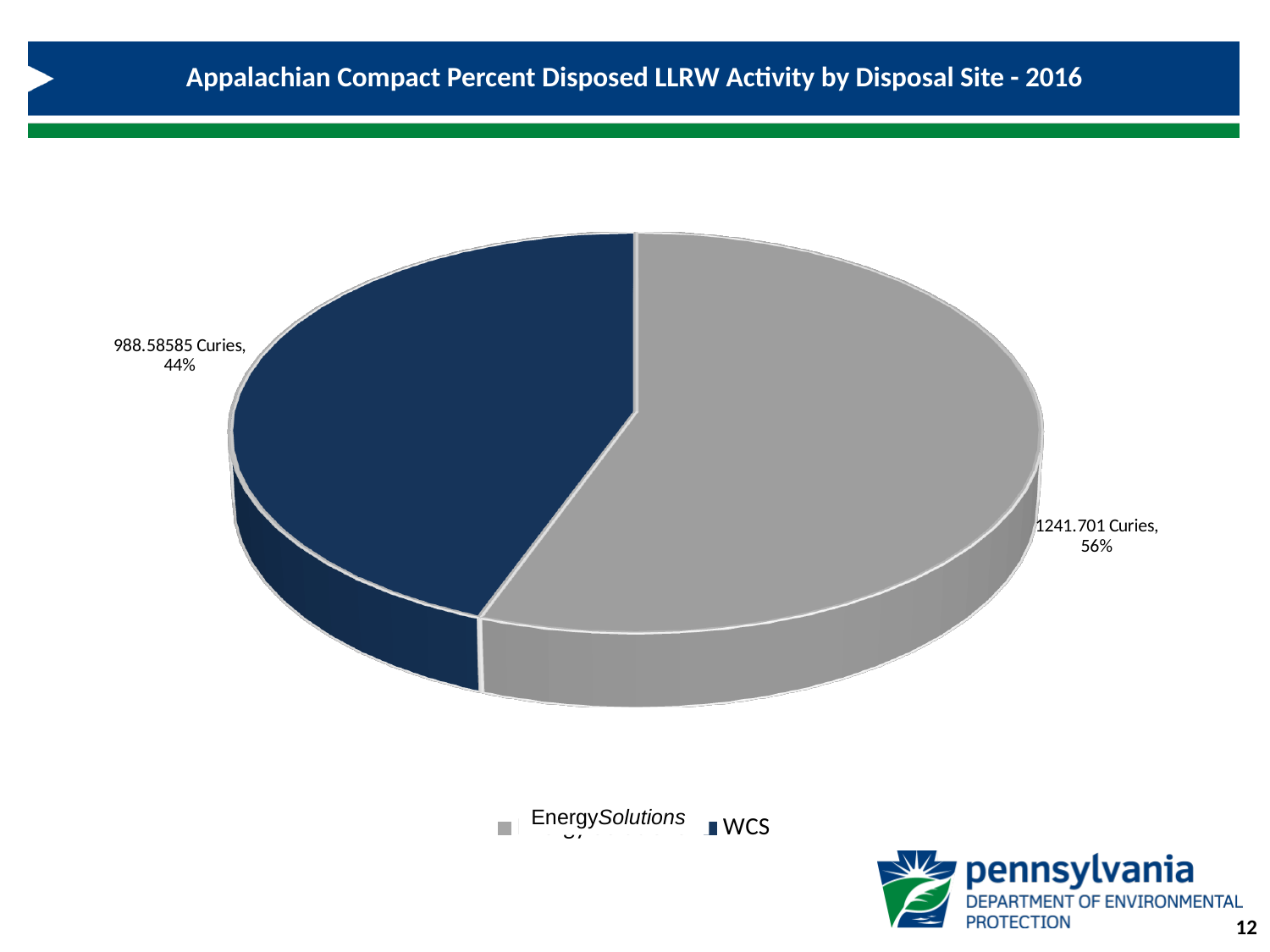
What kind of chart is shown on the slide? Pie chart How many slices does the pie chart have? 2 How many entries does the legend list? 2 What is the disposed activity for EnergySolutions? 1241.701 Curies Which disposal site received the smaller share of disposed activity? WCS Which colour represents WCS in the pie chart? Navy blue Which disposal site received the larger share of disposed activity? EnergySolutions What is the difference in Curies between the EnergySolutions and WCS slices? 253.11515 Curies What percentage of the disposed LLRW activity went to EnergySolutions? 56% What is the disposed activity for WCS? 988.58585 Curies What percentage of the disposed LLRW activity went to WCS? 44% Which is larger, the activity disposed at EnergySolutions or at WCS? EnergySolutions